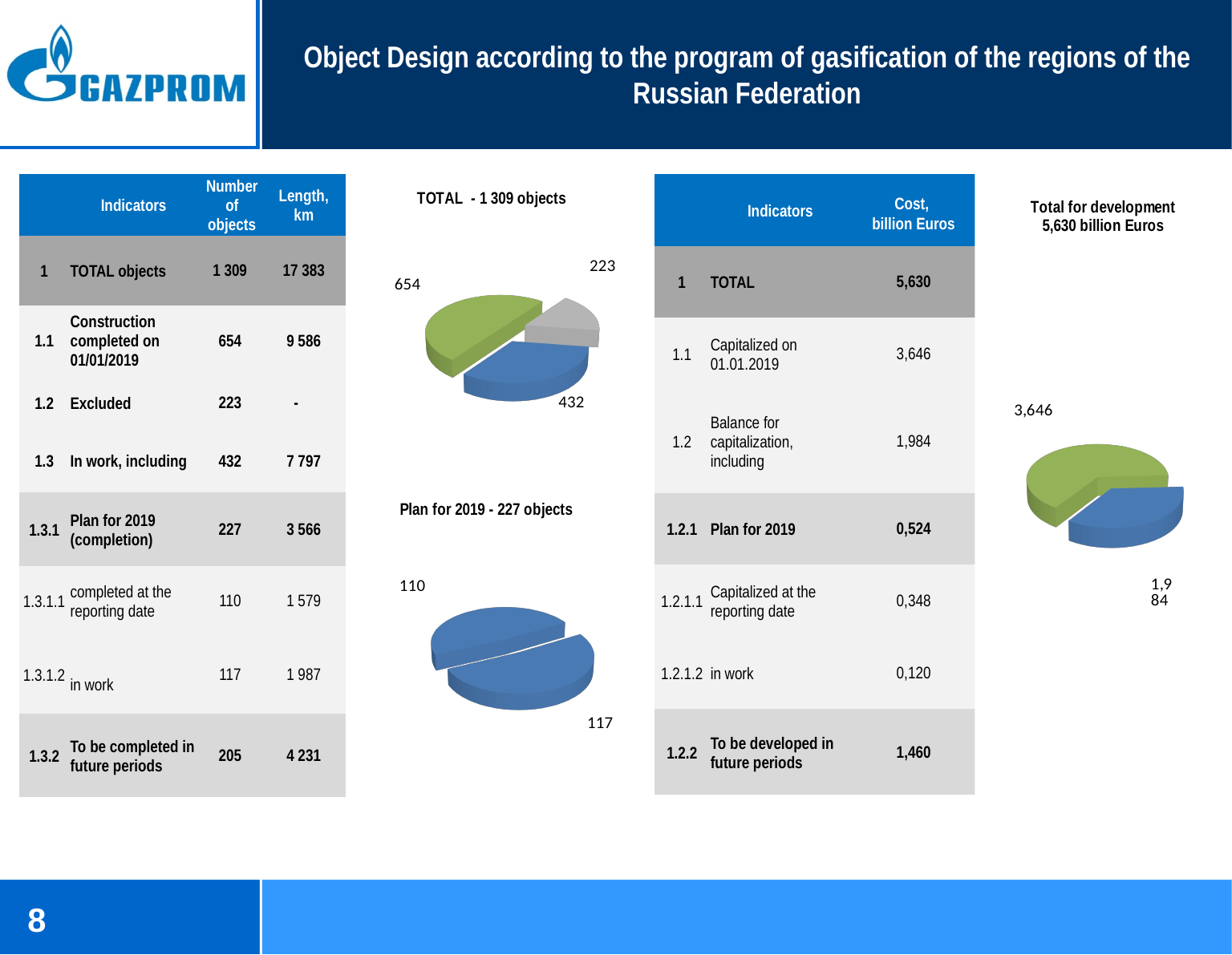
In the 'Total for development 5,630 billion Euros' pie chart, what is the difference between the 3,646 slice and the 1,984 slice? 1,662 In the 'Plan for 2019 - 227 objects' pie chart, which slice is larger, 110 or 117? 117 In the 'TOTAL - 1 309 objects' pie chart, what is the value of the smallest slice? 223 In the 'TOTAL - 1 309 objects' pie chart, what is the difference between the 654 slice and the 432 slice? 222 How many slices does the 'TOTAL - 1 309 objects' pie chart have? 3 In the 'TOTAL - 1 309 objects' pie chart, what share of the total does the 223 slice represent? 17% In the 'Total for development 5,630 billion Euros' pie chart, what is the value of the larger slice? 3,646 How many slices does the 'Plan for 2019 - 227 objects' pie chart have? 2 In the 'TOTAL - 1 309 objects' pie chart, what is the value of the largest slice? 654 In the 'Plan for 2019 - 227 objects' pie chart, what is the difference between the two slices? 7 What kind of chart is the 'TOTAL - 1 309 objects' chart? pie chart In the 'TOTAL - 1 309 objects' pie chart, what colour is the largest slice? green